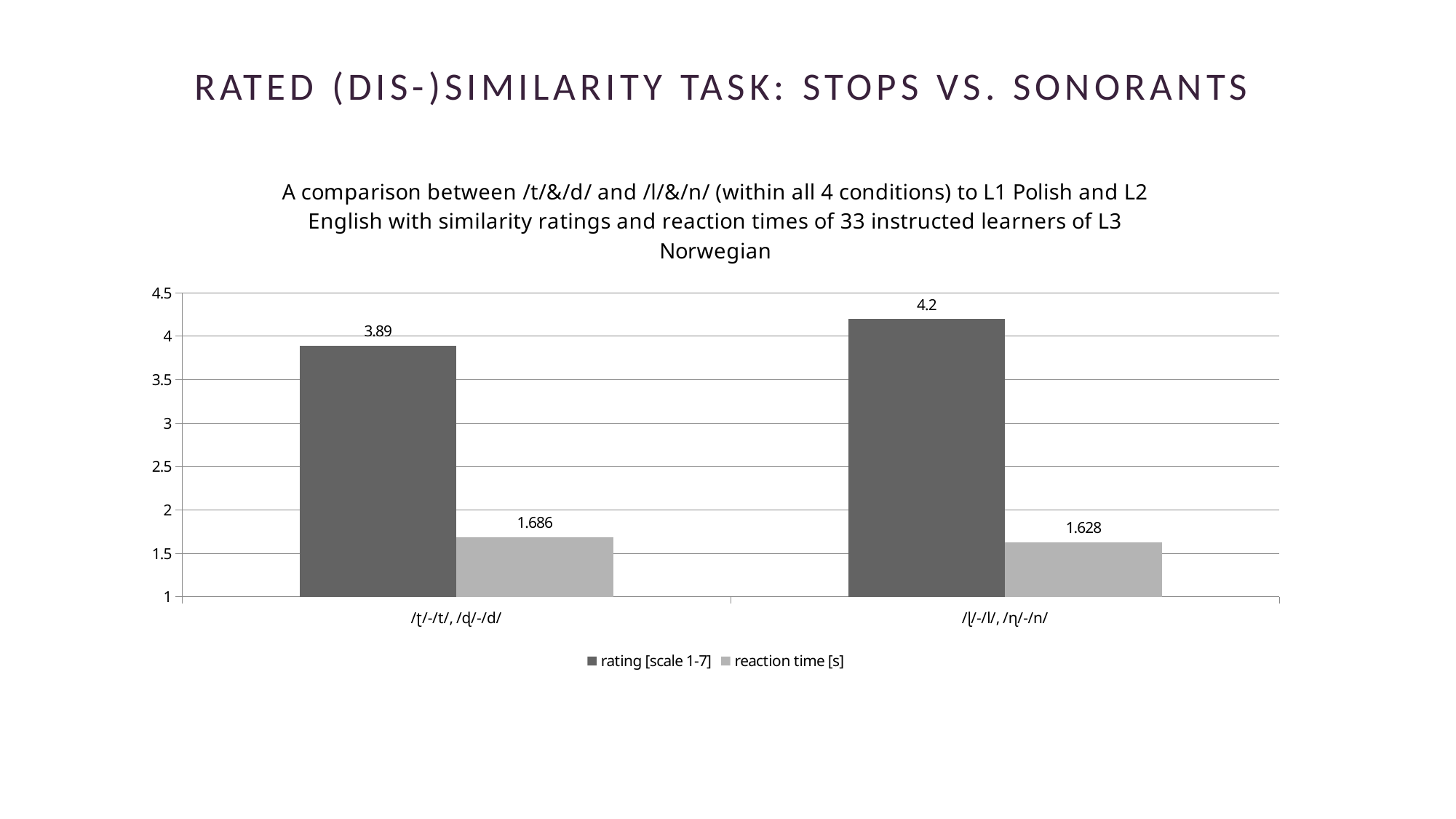
What is the difference between the reaction time for /ʈ/-/t/, /ɖ/-/d/ and the reaction time for /ɭ/-/l/, /ɳ/-/n/? 0.058 How many series does the legend list? 2 How many categories are shown on the x axis? 2 What kind of chart is shown on the slide? bar chart What is the rating [scale 1-7] for the right category, /ɭ/-/l/, /ɳ/-/n/? 4.2 What is the reaction time [s] for the right category, /ɭ/-/l/, /ɳ/-/n/? 1.628 Which category has the higher rating [scale 1-7]? /ɭ/-/l/, /ɳ/-/n/ Which category has the lower reaction time [s]? /ɭ/-/l/, /ɳ/-/n/ Is the rating for /ɭ/-/l/, /ɳ/-/n/ greater or less than 4? greater What is the reaction time [s] for the left category, /ʈ/-/t/, /ɖ/-/d/? 1.686 What is the rating [scale 1-7] for the left category, /ʈ/-/t/, /ɖ/-/d/? 3.89 What is the difference between the rating for /ɭ/-/l/, /ɳ/-/n/ and the rating for /ʈ/-/t/, /ɖ/-/d/? 0.31